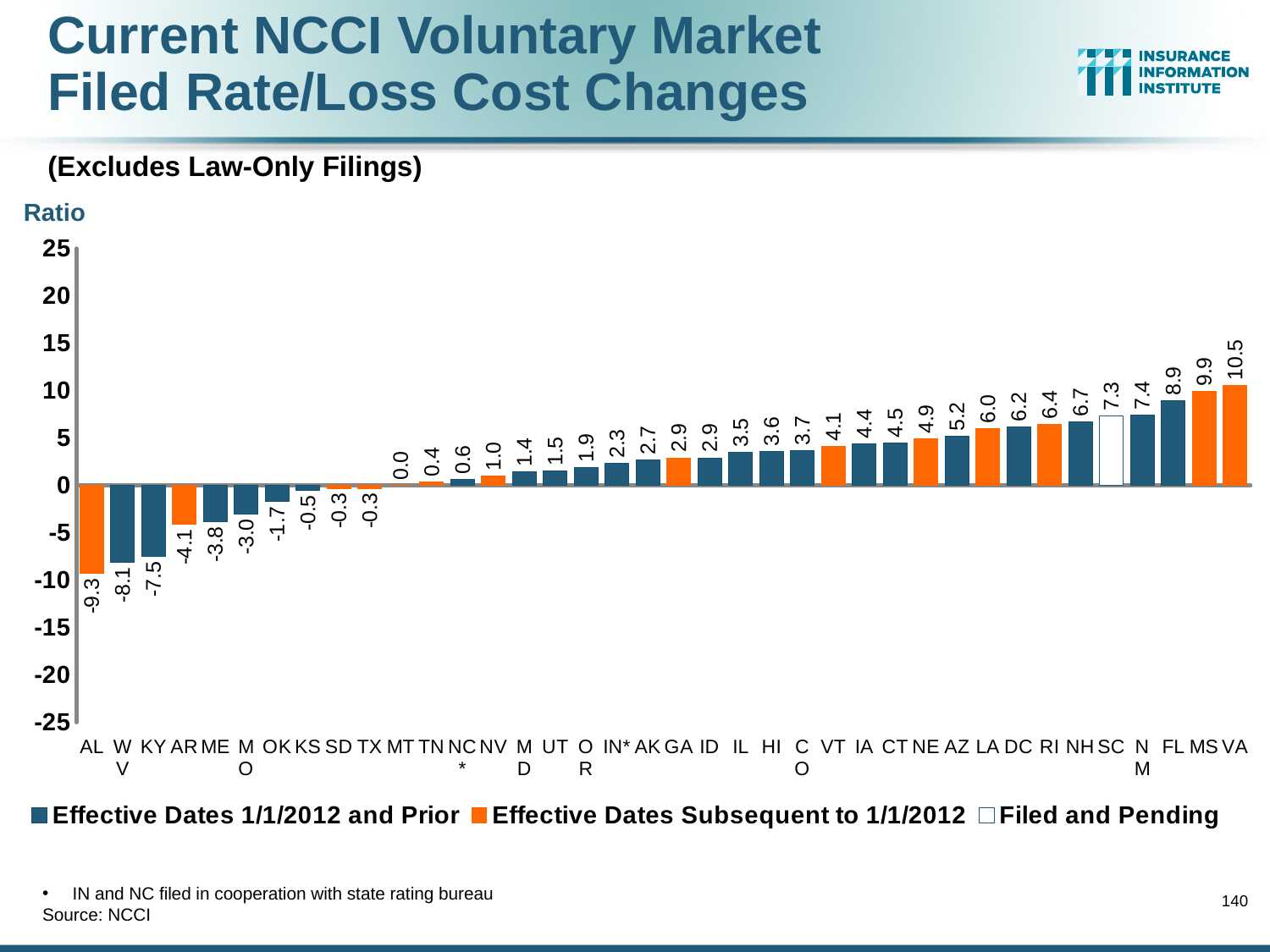
What is the value for VA? 10.5 How many states are shown on the chart? 38 Which state has the lowest value? AL What kind of chart is shown? Bar chart Which state is shown as Filed and Pending? SC Which state has the highest value? VA How many series does the legend list? 3 What is the value for AL? -9.3 What is the difference between the values for VA and AL? 19.8 What is the value for SC? 7.3 Which has the larger value, FL or MS? MS Do the values rise or fall from left to right along the x axis? Rise